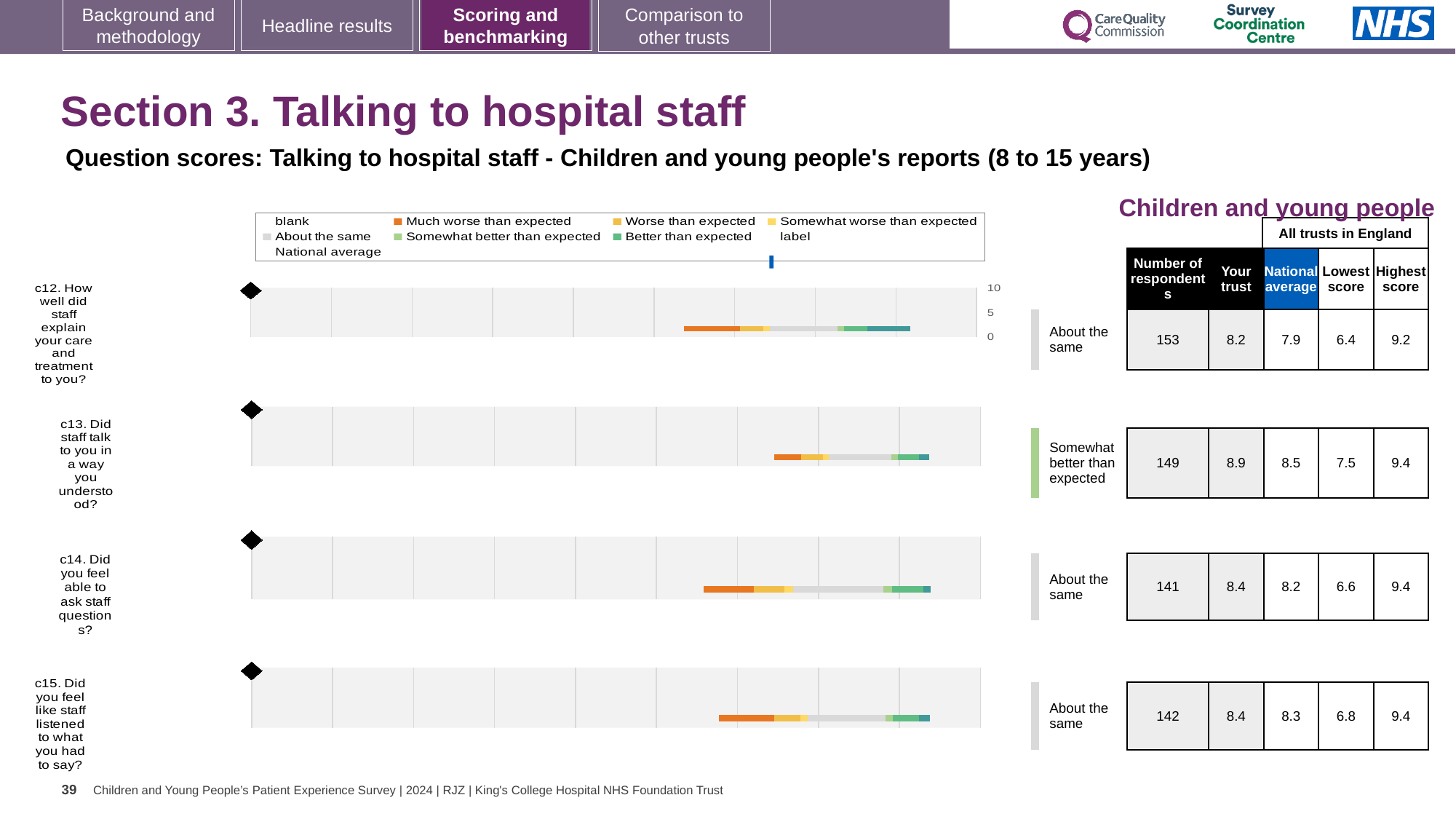
What kind of chart is used to show the question scores? Bar chart What is the national average score for question c12 (How well did staff explain your care and treatment to you?)? 7.9 For question c13, what is the difference between the 'Your trust' score and the national average? 0.4 What benchmark category is shown for question c15? About the same Which question has the lowest 'Lowest score' value across all trusts in England? c12 How many questions are charted on this slide? 4 For question c12, which is larger: the 'Your trust' score or the national average? Your trust What is the 'Your trust' score for question c13 (Did staff talk to you in a way you understood?)? 8.9 What benchmark category is shown for question c13? Somewhat better than expected What is the highest score across all trusts in England for question c15? 9.4 Which question has the highest 'Your trust' score? c13 How many respondents answered question c14 (Did you feel able to ask staff questions?)? 141